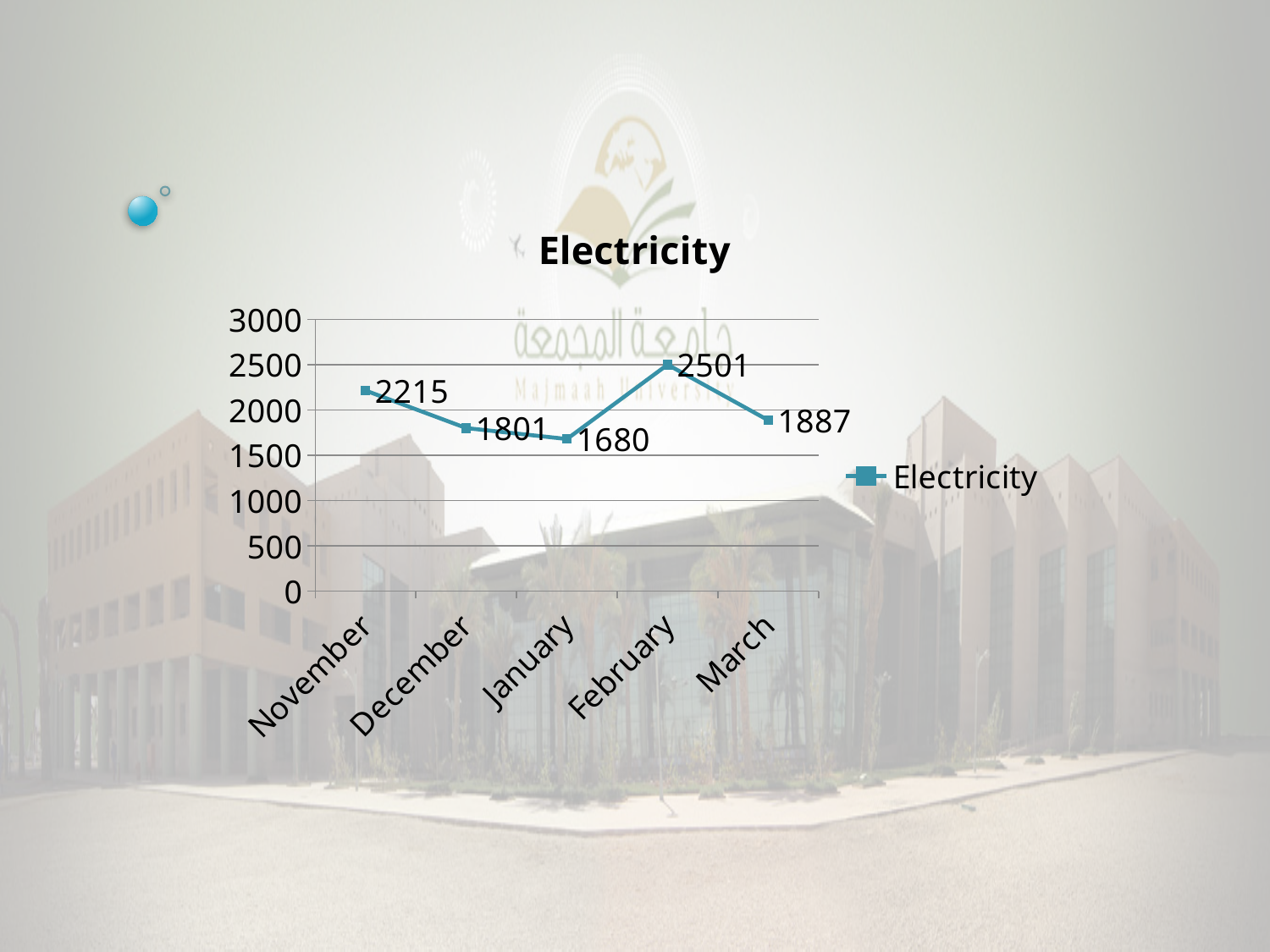
What is the title of the chart? Electricity Is the Electricity value for January greater or less than 2000? less Which month has the highest Electricity value? February Which month has the lowest Electricity value? January What is the Electricity value for March? 1887 What is the Electricity value for February? 2501 What is the Electricity value for November? 2215 How many months are plotted on the chart? 5 What kind of chart is shown on the slide? line chart What is the difference between the Electricity values for February and January? 821 What is the difference between the Electricity values for November and December? 414 Which is larger, the Electricity value for December or for March? March